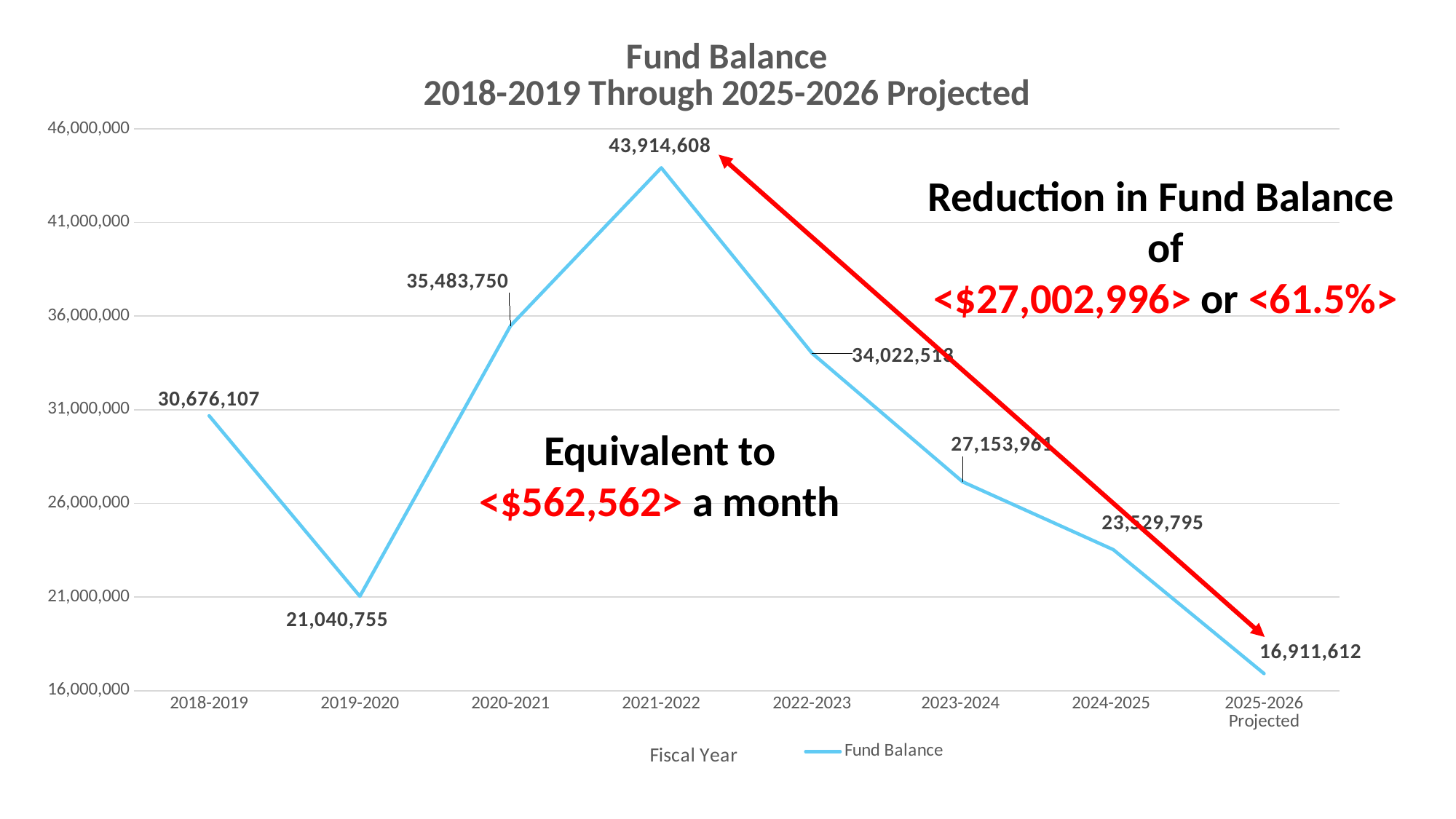
What is the fund balance for 2019-2020? 21,040,755 Is the fund balance for 2022-2023 greater or less than 31,000,000? greater What is the fund balance for 2021-2022? 43,914,608 What is the difference between the fund balance in 2018-2019 and in 2019-2020? 9,635,352 What is the difference between the fund balance in 2021-2022 and the projected fund balance in 2025-2026? 27,002,996 Which is larger, the fund balance in 2020-2021 or in 2018-2019? 2020-2021 Which fiscal year has the highest fund balance? 2021-2022 Which fiscal year has the lowest fund balance? 2025-2026 Projected What is the projected fund balance for 2025-2026? 16,911,612 What kind of chart is shown on the slide? line chart What is the fund balance for 2024-2025? 23,529,795 How many fiscal years are plotted on the chart? 8